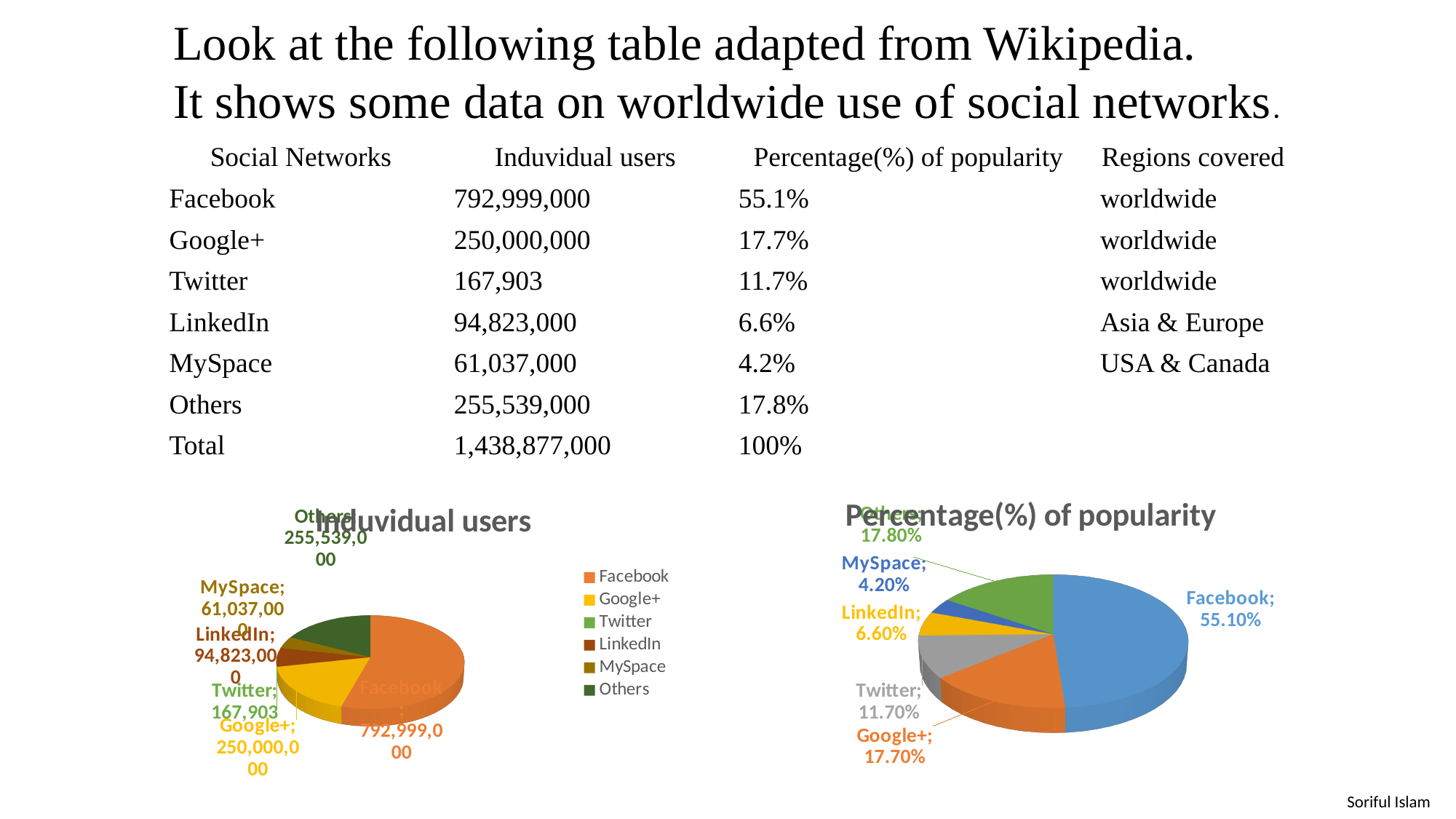
In the "Percentage(%) of popularity" chart, what is the value for Facebook? 55.10% In the "Percentage(%) of popularity" chart, what is the value for MySpace? 4.20% In the "Percentage(%) of popularity" chart, what is the difference between the values for Google+ and Twitter? 6.00% In the "Induvidual users" chart, what is the value for Facebook? 792,999,000 In the "Percentage(%) of popularity" chart, how many slices does the pie have? 6 In the "Induvidual users" chart, which is larger, the value for Google+ or the value for LinkedIn? Google+ In the "Induvidual users" chart, which category has the largest slice? Facebook In the "Induvidual users" chart, which category has the smallest value? Twitter In the "Percentage(%) of popularity" chart, which category has the smallest slice? MySpace In the "Induvidual users" chart, how many entries does the legend list? 6 What kind of chart is the "Induvidual users" chart? pie chart In the "Induvidual users" chart, what is the value for Twitter? 167,903